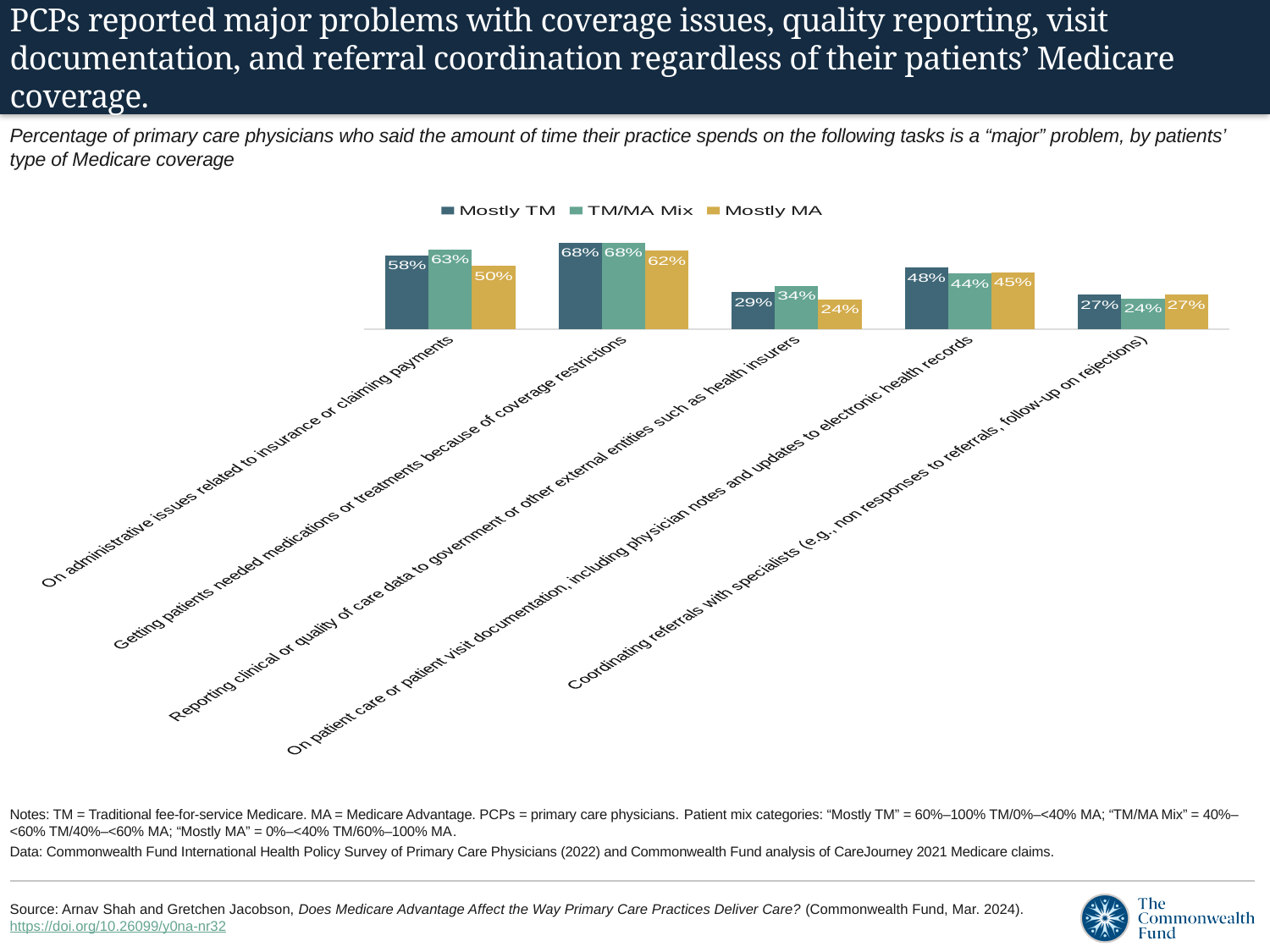
What is the difference between the TM/MA Mix and Mostly MA values for reporting clinical or quality of care data? 10 percentage points What are the three series named in the legend? Mostly TM, TM/MA Mix, Mostly MA How many tasks (categories) are shown on the x axis? 5 What is the Mostly MA value for coordinating referrals with specialists? 27% How many series does the legend list? 3 What is the Mostly TM value for getting patients needed medications or treatments because of coverage restrictions? 68% What percentage of PCPs with Mostly MA patients said time spent on administrative issues related to insurance or claiming payments is a major problem? 50% What is the TM/MA Mix value for reporting clinical or quality of care data to government or other external entities? 34% For administrative issues related to insurance or claiming payments, which is larger: the Mostly TM value or the TM/MA Mix value? TM/MA Mix Which task has the highest Mostly MA value? Getting patients needed medications or treatments because of coverage restrictions What kind of chart is shown on the slide? Bar chart Which task has the lowest TM/MA Mix value? Coordinating referrals with specialists